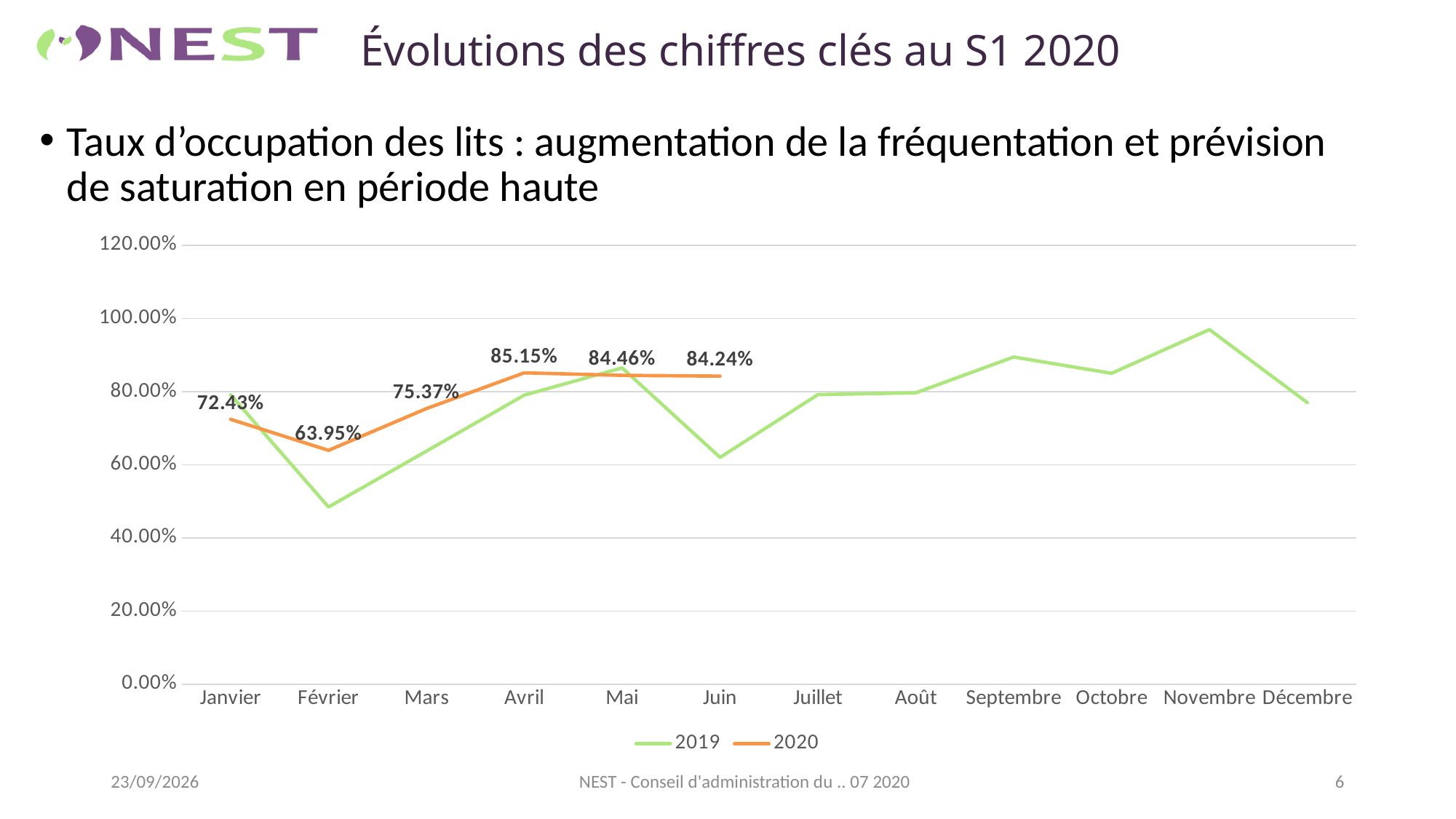
In which month does the 2019 series reach its highest point? Novembre How many months are shown on the x axis? 12 Is the 2019 value for Novembre greater or less than 80.00%? greater In which month does the 2020 series reach its highest value? Avril For the 2020 series, which is larger: the value for Janvier or the value for Mars? Mars What kind of chart is shown on the slide? line chart In which month is the 2020 series at its lowest? Février How many series does the legend list? 2 What is the difference between the 2020 values for Avril and Février? 21.20% What is the bed occupancy rate for 2020 in Avril? 85.15% Is the 2019 value for Février greater or less than 60.00%? less What is the value of the 2020 series in Février? 63.95%